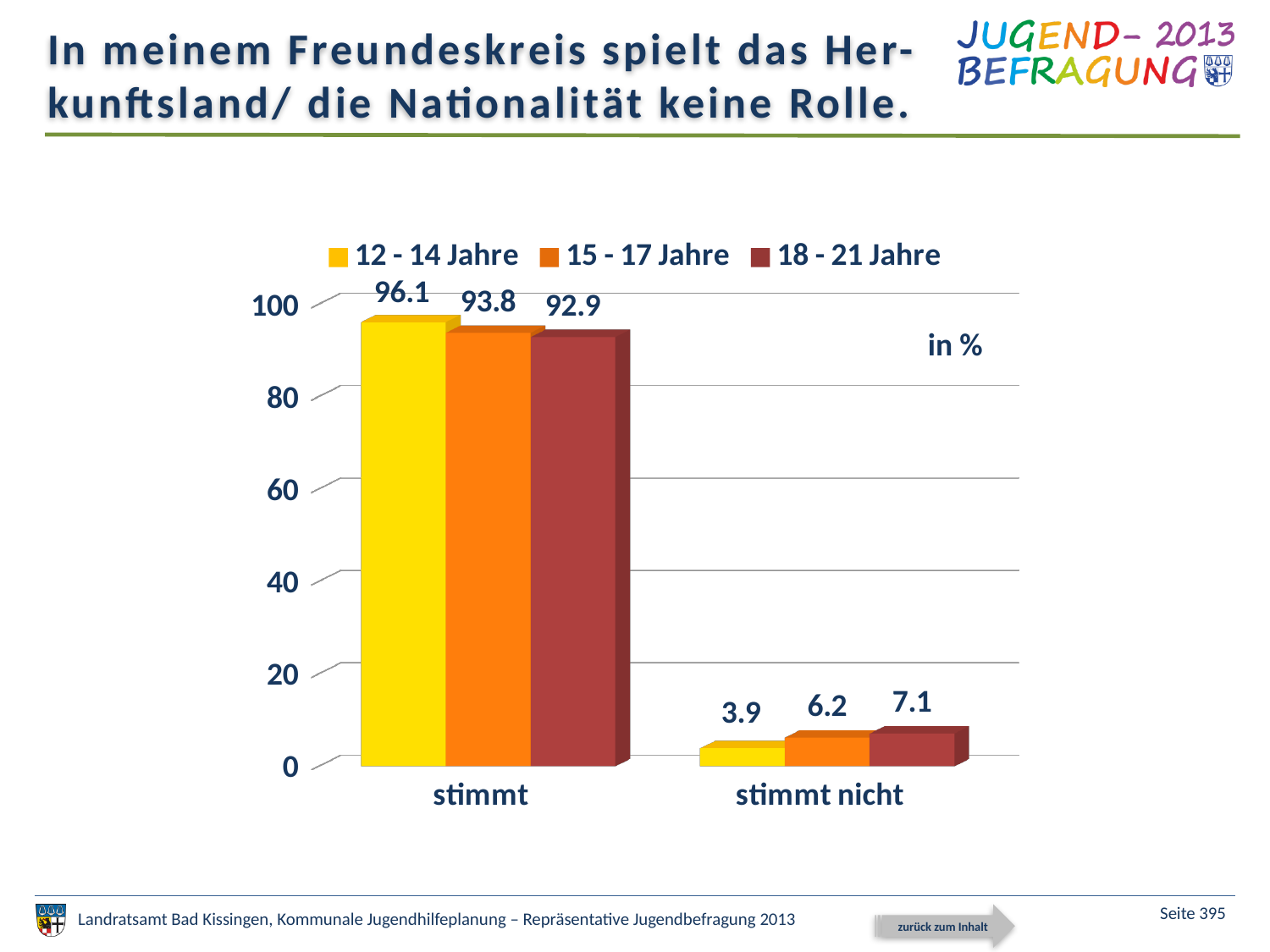
What is the value for the 15 - 17 Jahre series in the "stimmt" category? 93.8 What is the value for the 12 - 14 Jahre series in the "stimmt" category? 96.1 What is the difference between the 12 - 14 Jahre and 18 - 21 Jahre values in the "stimmt" category? 3.2 Which is larger in the "stimmt nicht" category: the 15 - 17 Jahre value or the 18 - 21 Jahre value? 18 - 21 Jahre How many categories are shown on the x axis? 2 Which age group has the highest value in the "stimmt" category? 12 - 14 Jahre What is the value for the 18 - 21 Jahre series in the "stimmt nicht" category? 7.1 What unit is indicated for the values in the chart? in % How many series does the legend list? 3 Which age group has the lowest value in the "stimmt nicht" category? 12 - 14 Jahre Is the value for 18 - 21 Jahre in the "stimmt" category greater or less than 80? greater What kind of chart is shown on the slide? bar chart